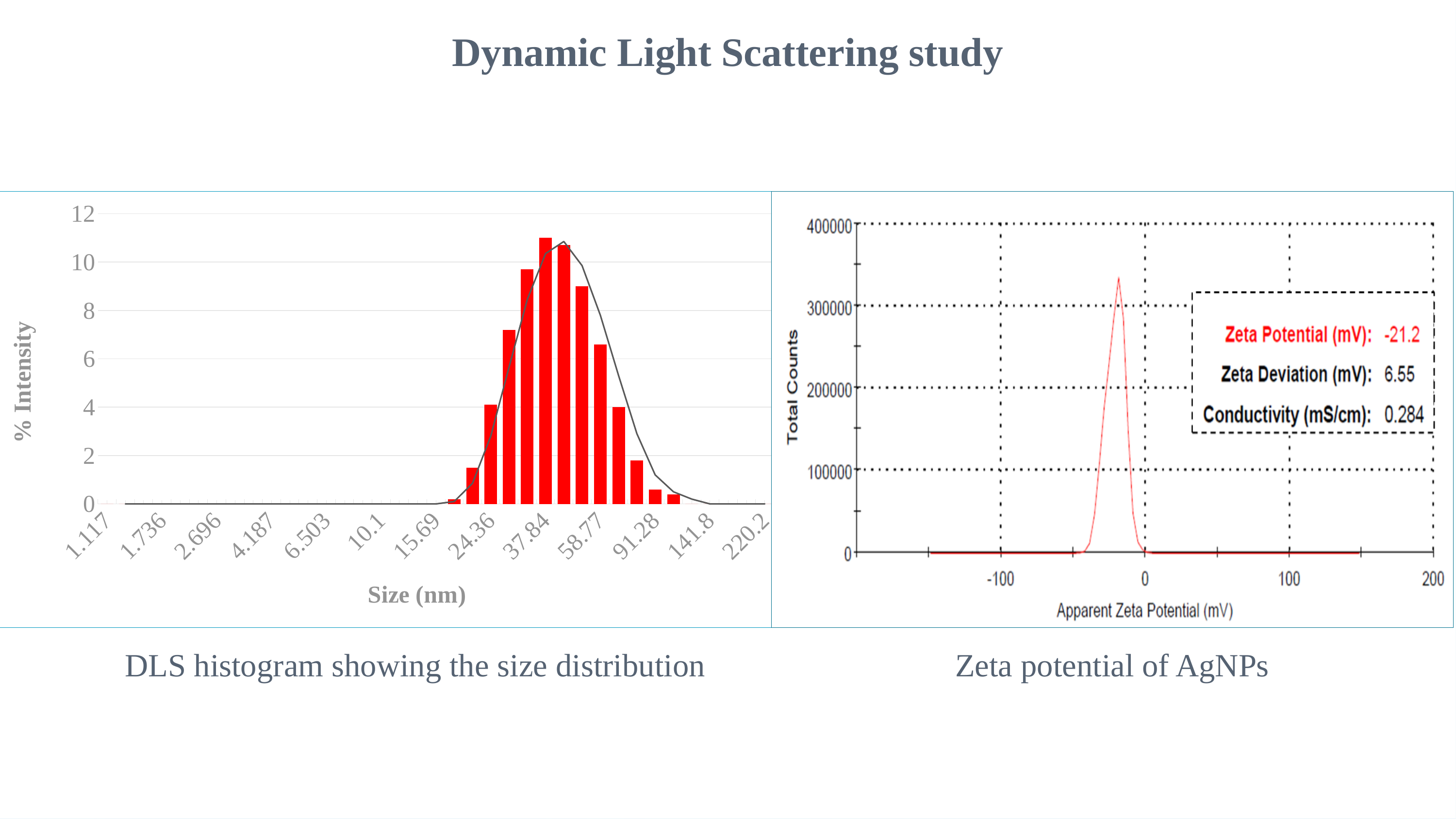
In the DLS histogram on the left, do the bars rise or fall as size increases from 58.77 nm to 141.8 nm? fall In the zeta potential chart on the right, is the peak of the curve greater or less than 300000 total counts? greater In the zeta potential chart on the right, what is the Zeta Deviation (mV) value shown? 6.55 In the DLS histogram on the left, is the tallest bar greater or less than 12 % intensity? less In the zeta potential chart on the right, what is the Conductivity (mS/cm) value shown? 0.284 In the DLS histogram on the left, what kind of chart is used to show the size distribution? bar chart In the DLS histogram on the left, how many size labels are shown along the x axis? 13 In the DLS histogram on the left, what is the label of the x axis? Size (nm) In the DLS histogram on the left, what is the label of the y axis? % Intensity In the DLS histogram on the left, is the tallest bar greater or less than 10 % intensity? greater In the zeta potential chart on the right, what is the Zeta Potential (mV) value shown? -21.2 In the DLS histogram on the left, do the bars rise or fall as size increases from 24.36 nm to 37.84 nm? rise